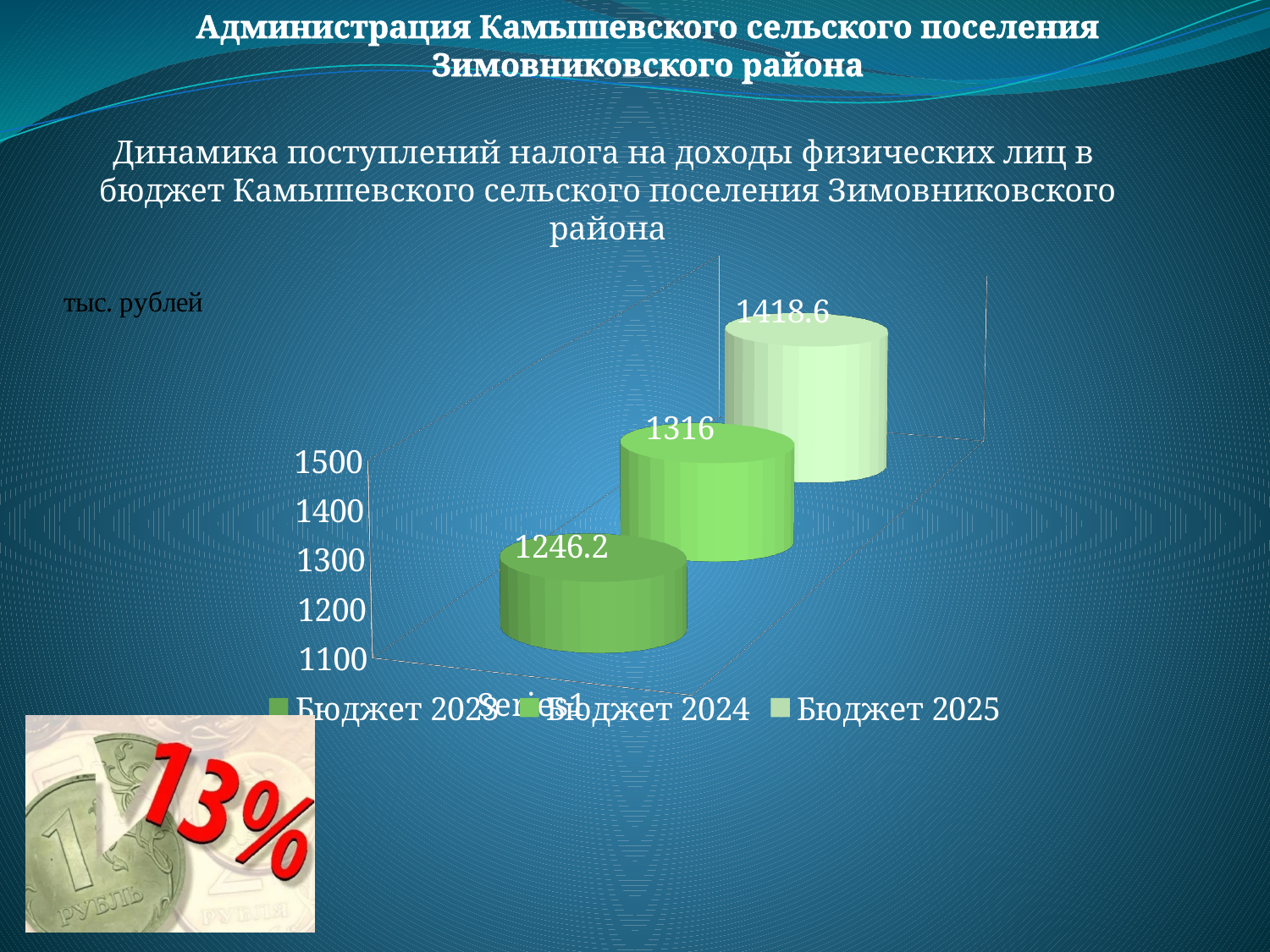
What is the value for Бюджет 2024? 1316 What is the difference between the values for Бюджет 2025 and Бюджет 2023? 172.4 Which series has the lowest value? Бюджет 2023 Which is larger, the value for Бюджет 2024 or Бюджет 2025? Бюджет 2025 What is the value for Бюджет 2023? 1246.2 How many series does the legend list? 3 What is the value for Бюджет 2025? 1418.6 What kind of chart is shown on the slide? bar chart Which series has the highest value? Бюджет 2025 What is the difference between the values for Бюджет 2024 and Бюджет 2023? 69.8 Is the value for Бюджет 2025 greater or less than 1400? greater Do the values rise or fall from Бюджет 2023 to Бюджет 2025? rise